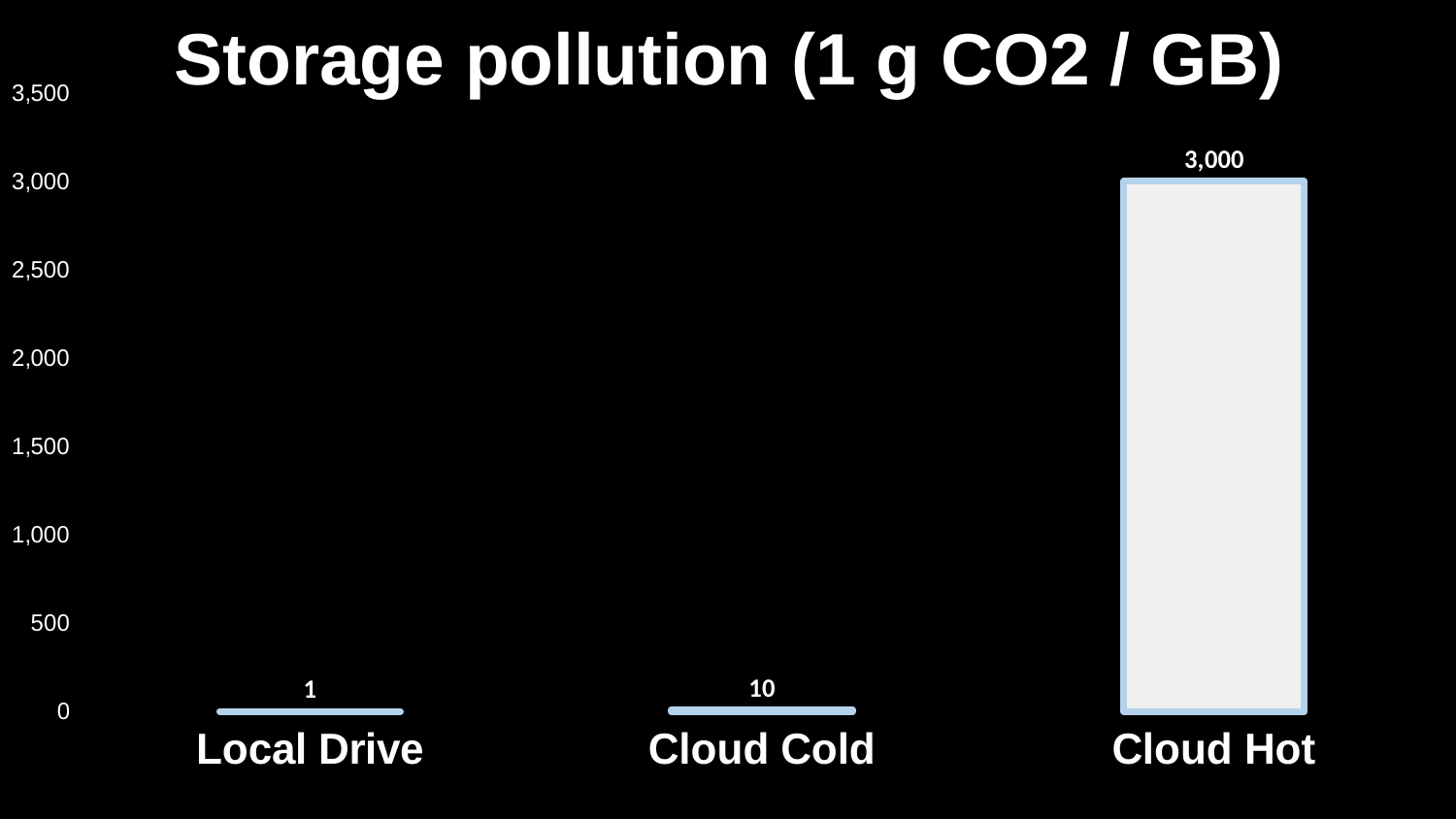
Which is larger, the value for Cloud Hot or the value for Local Drive? Cloud Hot What is the value for Cloud Cold? 10 Which category has the lowest value? Local Drive What is the title of the chart? Storage pollution (1 g CO2 / GB) What is the difference between the values for Cloud Cold and Local Drive? 9 Which category has the highest value? Cloud Hot Is the value for Cloud Hot greater or less than 2,500? greater What is the value for Cloud Hot? 3,000 How many categories are shown on the chart? 3 What is the value for Local Drive? 1 What kind of chart is shown on the slide? bar chart What is the difference between the values for Cloud Hot and Cloud Cold? 2,990